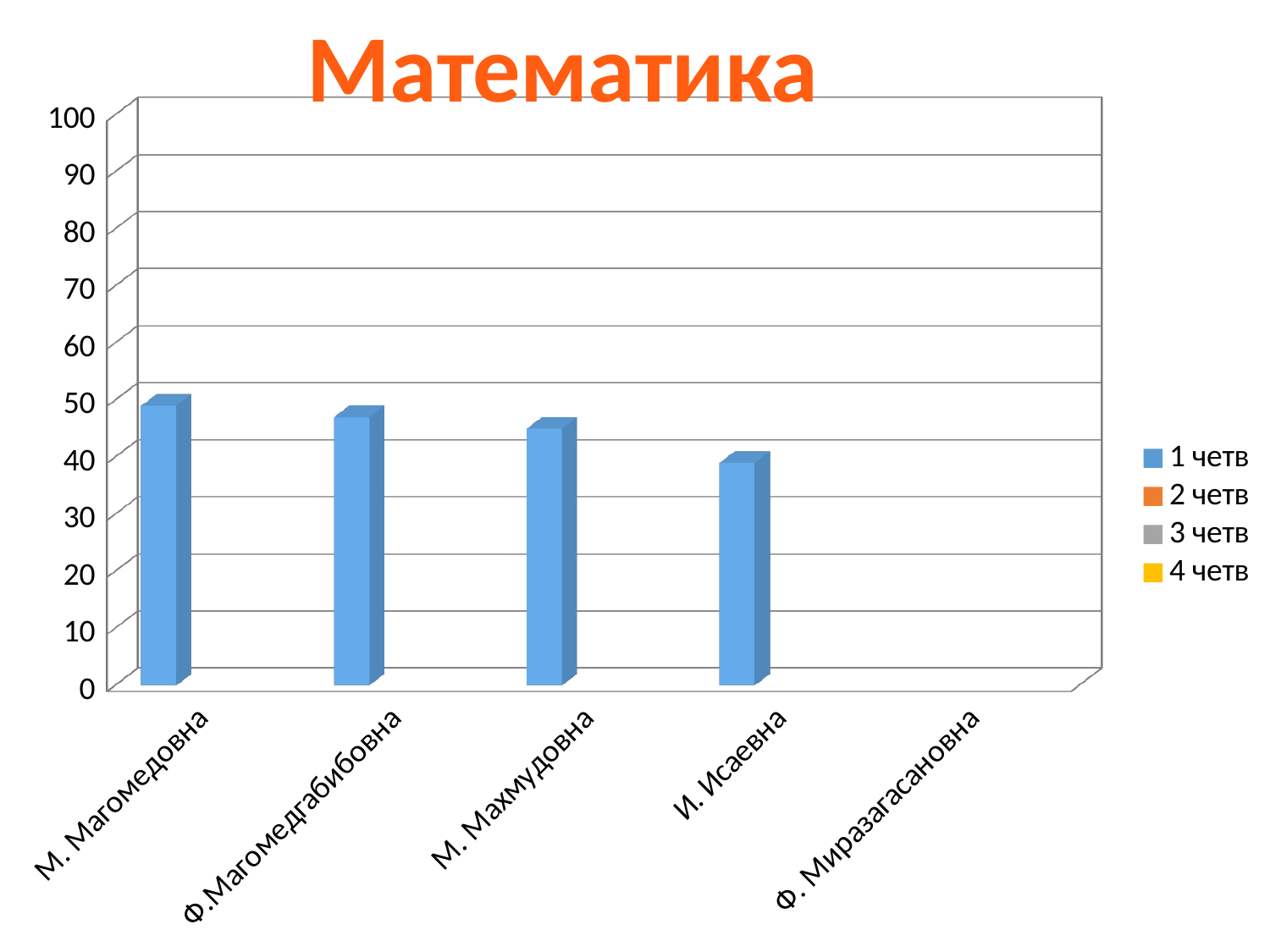
How many series does the legend list? 4 Among the categories with a visible bar, which has the lowest value for 1 четв? И. Исаевна What is the title of the chart? Математика Which legend entry is shown in blue? 1 четв Is the 1 четв value for М. Магомедовна greater or less than 40? greater Which is larger, the 1 четв value for М. Магомедовна or for И. Исаевна? М. Магомедовна Is the 1 четв value for М. Махмудовна greater or less than 40? greater How many categories are shown on the x axis? 5 Which category has the highest value for 1 четв? М. Магомедовна Do the 1 четв values rise or fall from М. Магомедовна to И. Исаевна along the x axis? fall What kind of chart is shown on the slide? bar chart Is the 1 четв value for И. Исаевна greater or less than 50? less